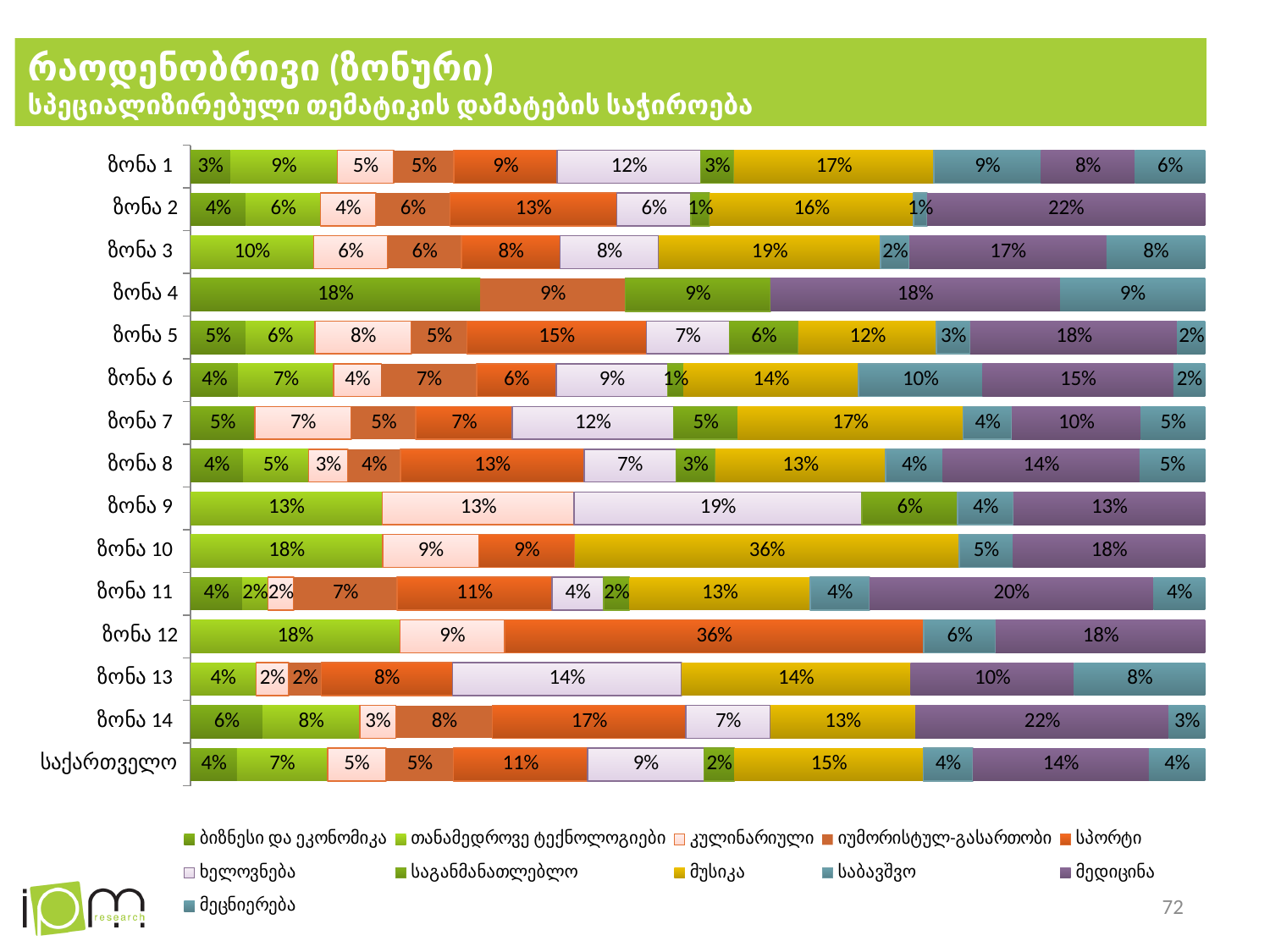
What is the value of მუსიკა for ზონა 10? 36% Which series has the largest segment in the ზონა 12 bar? სპორტი What is the value of სპორტი for საქართველო? 11% What is the value of ბიზნესი და ეკონომიკა for ზონა 4? 18% What kind of chart is shown on the slide? stacked bar chart For საქართველო, what is the difference between the მუსიკა value and the ბიზნესი და ეკონომიკა value? 11 percentage points What is the value of მედიცინა for ზონა 2? 22% What is the main title of the slide? რაოდენობრივი (ზონური) How many categories (zones plus საქართველო) are plotted on the y axis? 15 Which has the larger მედიცინა value, ზონა 14 or ზონა 1? ზონა 14 What is the value of მუსიკა for ზონა 1? 17% How many series does the legend list? 11